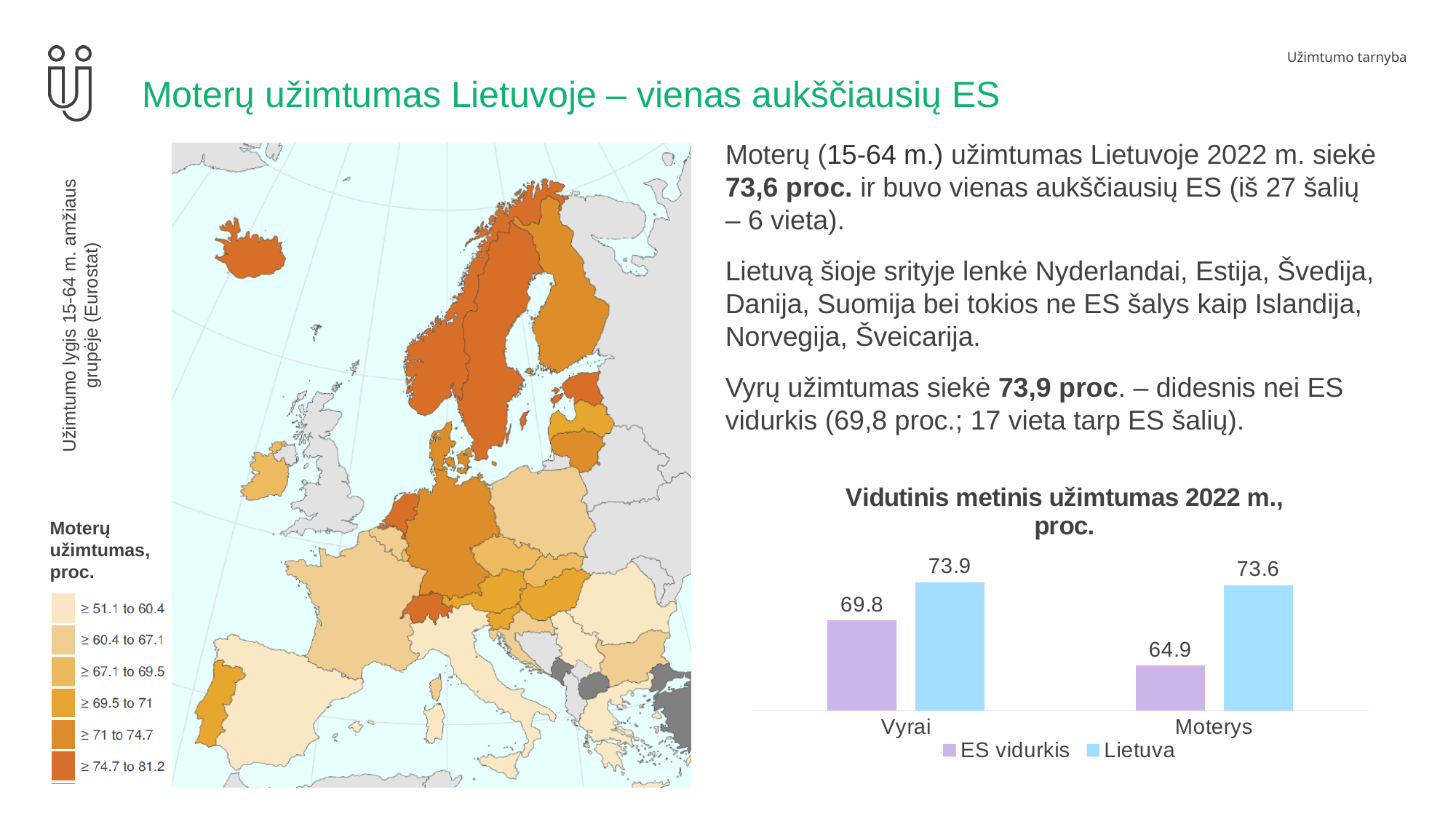
In the bar chart titled "Vidutinis metinis užimtumas 2022 m., proc.", what is the value for Lietuva in the Vyrai category? 73.9 In the bar chart titled "Vidutinis metinis užimtumas 2022 m., proc.", what is the value for Lietuva in the Moterys category? 73.6 In the bar chart titled "Vidutinis metinis užimtumas 2022 m., proc.", what is the value for ES vidurkis in the Moterys category? 64.9 In the bar chart titled "Vidutinis metinis užimtumas 2022 m., proc.", what is the value for ES vidurkis in the Vyrai category? 69.8 In the bar chart titled "Vidutinis metinis užimtumas 2022 m., proc.", what is the difference between the Lietuva and ES vidurkis values for Vyrai? 4.1 In the bar chart titled "Vidutinis metinis užimtumas 2022 m., proc.", how much higher is the Lietuva value than the ES vidurkis value for Moterys? 8.7 In the bar chart titled "Vidutinis metinis užimtumas 2022 m., proc.", how many categories are shown on the x axis? 2 In the bar chart titled "Vidutinis metinis užimtumas 2022 m., proc.", how many series does the legend list? 2 In the bar chart titled "Vidutinis metinis užimtumas 2022 m., proc.", is the ES vidurkis value larger for Vyrai or for Moterys? Vyrai In the bar chart titled "Vidutinis metinis užimtumas 2022 m., proc.", which bar has the lowest value? ES vidurkis, Moterys (64.9) What type of chart is the chart on the right side of the slide, below the text? Bar chart In the bar chart titled "Vidutinis metinis užimtumas 2022 m., proc.", which bar has the highest value? Lietuva, Vyrai (73.9)